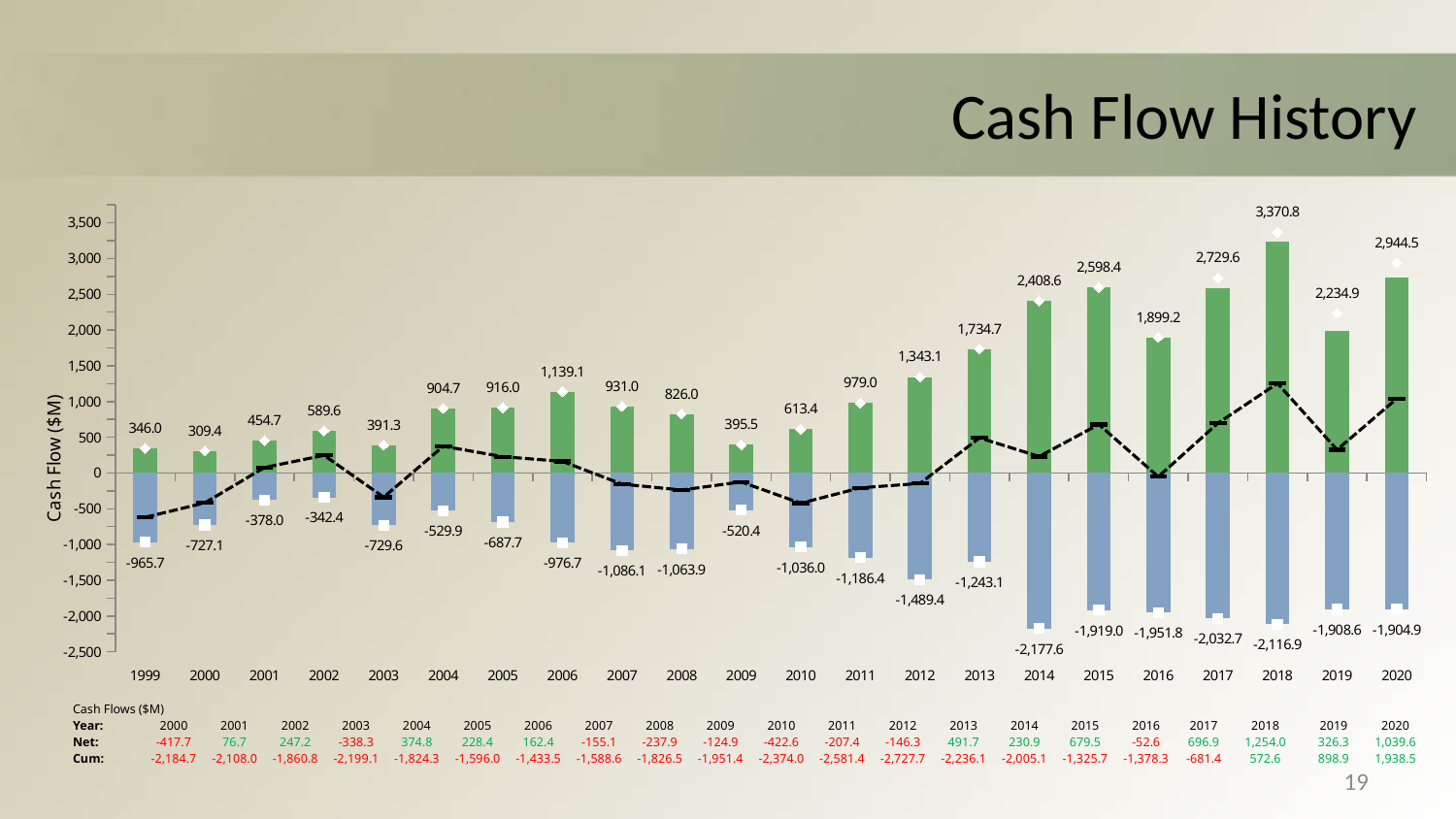
What is the value of the green (positive) bar for 2006? 1,139.1 What is the label on the vertical axis of the chart? Cash Flow ($M) What is the difference between the green bar values for 2018 and 2017? 641.2 What is the value of the green bar for 2020? 2,944.5 What is the title of the chart? Cash Flow History Which year has the larger green bar, 2014 or 2015? 2015 How many years are shown on the x axis of the chart? 22 What is the value of the blue (negative) bar for 2012? -1,489.4 Which year has the highest green (positive) bar? 2018 Which year has the lowest green (positive) bar? 2000 Is the dashed line value for 2018 greater or less than 1,000? greater Which year has the largest negative (blue) bar? 2014